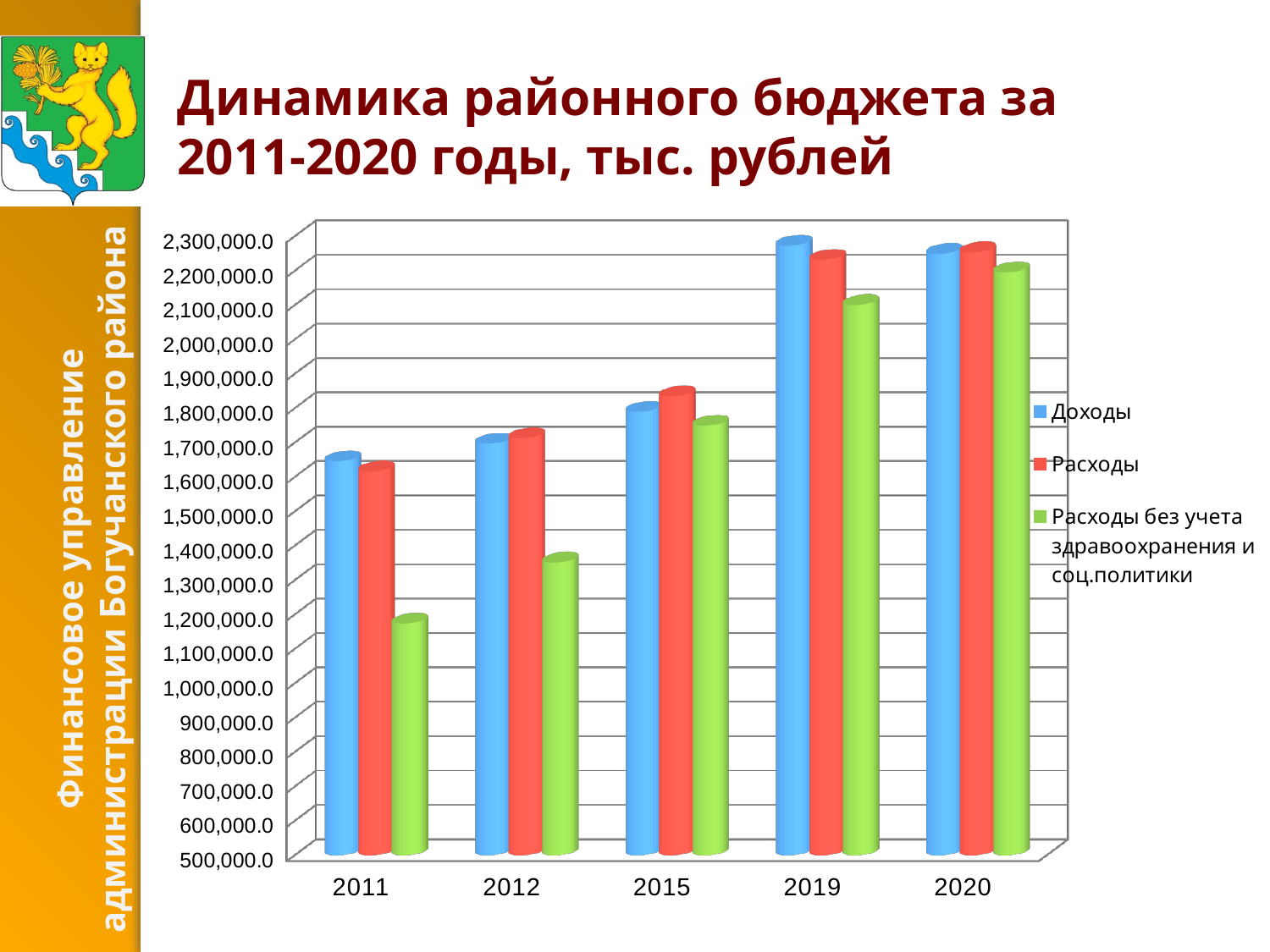
What kind of chart is shown on the slide? bar chart How many series does the chart legend list? 3 Is the value for Расходы без учета здравоохранения и соц.политики in 2015 greater or less than 1,700,000.0? greater In which year is the value for Расходы без учета здравоохранения и соц.политики the lowest? 2011 Is the value for Доходы in 2019 greater or less than 2,200,000.0? greater In 2011, which is larger: Доходы or Расходы без учета здравоохранения и соц.политики? Доходы Do the values for Расходы без учета здравоохранения и соц.политики rise or fall from 2011 to 2020? rise Is the value for Расходы без учета здравоохранения и соц.политики in 2011 greater or less than 1,300,000.0? less How many years are shown on the x axis of the chart? 5 What is the title of the chart on the slide? Динамика районного бюджета за 2011-2020 годы, тыс. рублей In which year is the value for Доходы the lowest? 2011